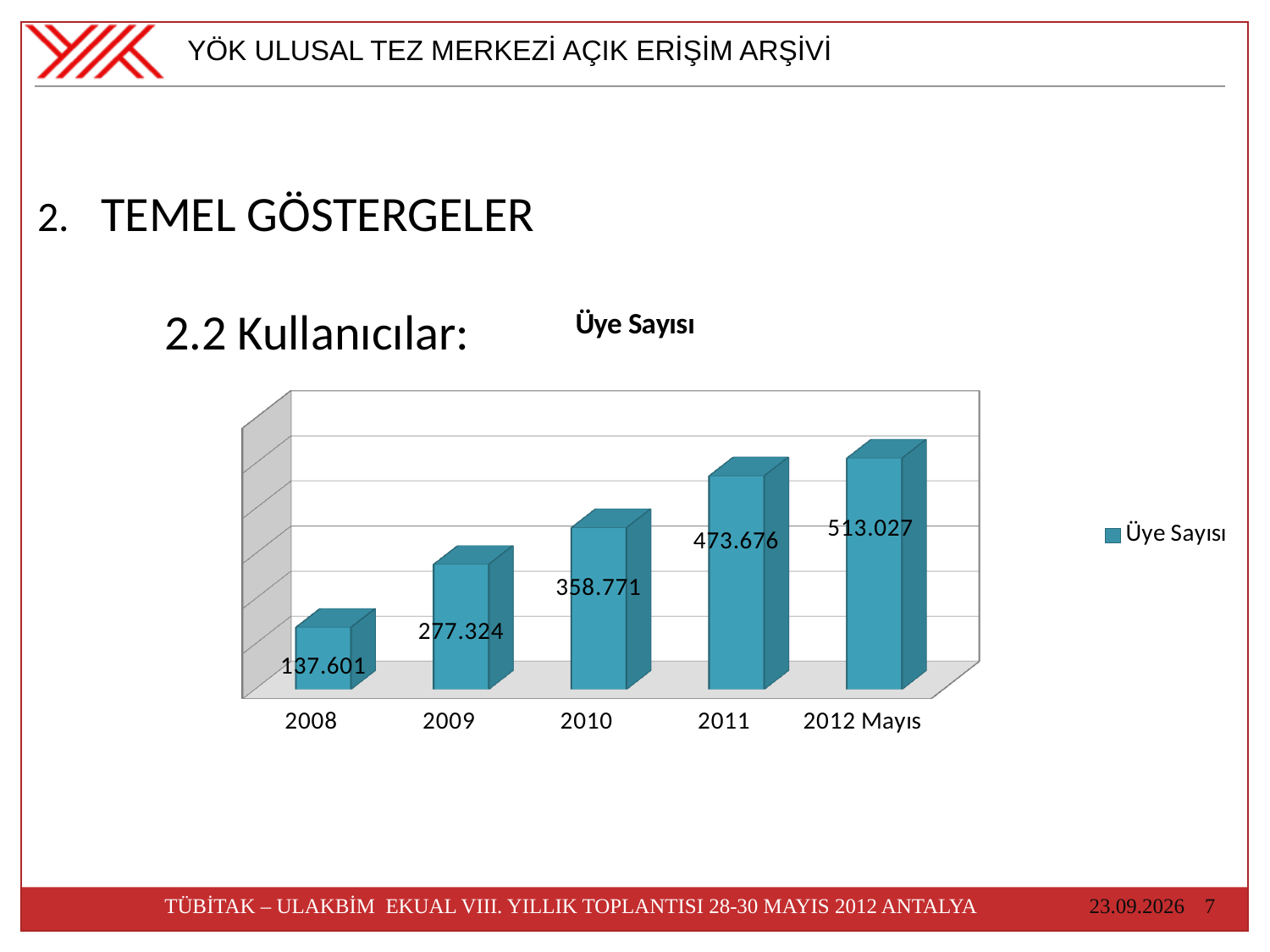
What is the value for 2010 in the Üye Sayısı chart? 358.771 What is the value for 2008 in the Üye Sayısı chart? 137.601 Which category has the highest value in the Üye Sayısı chart? 2012 Mayıs Which is larger in the Üye Sayısı chart, the value for 2009 or the value for 2011? 2011 Do the values in the Üye Sayısı chart rise or fall from 2008 to 2012 Mayıs? Rise Which category has the lowest value in the Üye Sayısı chart? 2008 What kind of chart is the Üye Sayısı chart? Bar chart How many series does the legend of the Üye Sayısı chart list? 1 What is the difference between the values for 2012 Mayıs and 2011 in the Üye Sayısı chart? 39.351 What is the value for 2012 Mayıs in the Üye Sayısı chart? 513.027 How many categories are shown on the x axis of the Üye Sayısı chart? 5 What is the difference between the values for 2009 and 2008 in the Üye Sayısı chart? 139.723